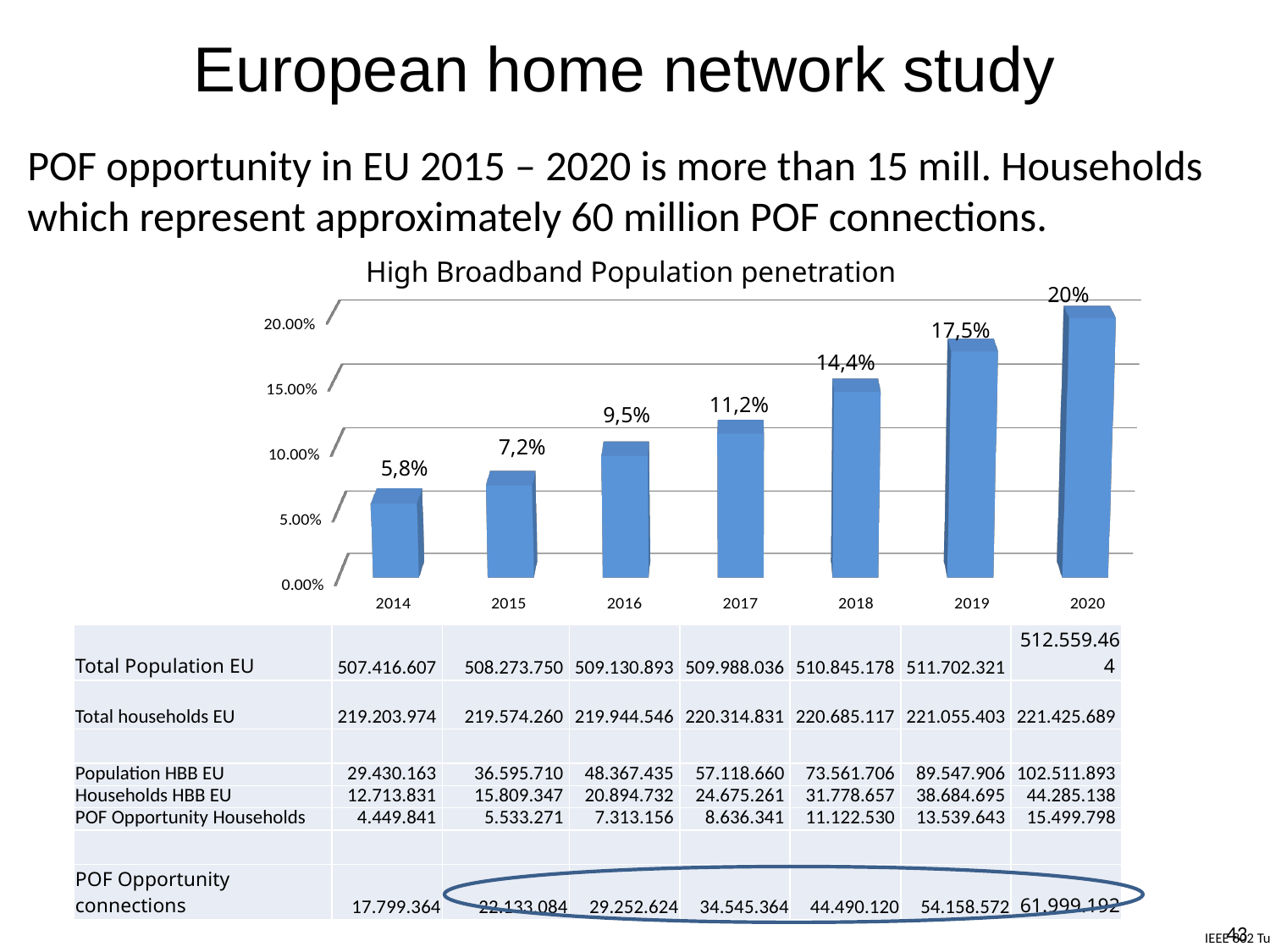
What is the title of the chart? High Broadband Population penetration What is the difference between the penetration values for 2019 and 2018? 3,1% Is the penetration value for 2018 greater or less than 15.00%? less How many years are shown on the x axis of the chart? 7 Which year has the highest High Broadband Population penetration? 2020 Which year has the lowest High Broadband Population penetration? 2014 Which year has a higher penetration value, 2015 or 2017? 2017 What is the High Broadband Population penetration value for 2019? 17,5% What kind of chart is used to show High Broadband Population penetration? bar chart What is the High Broadband Population penetration value for 2014? 5,8% What is the High Broadband Population penetration value for 2016? 9,5% Do the penetration values rise or fall from 2014 to 2020? rise